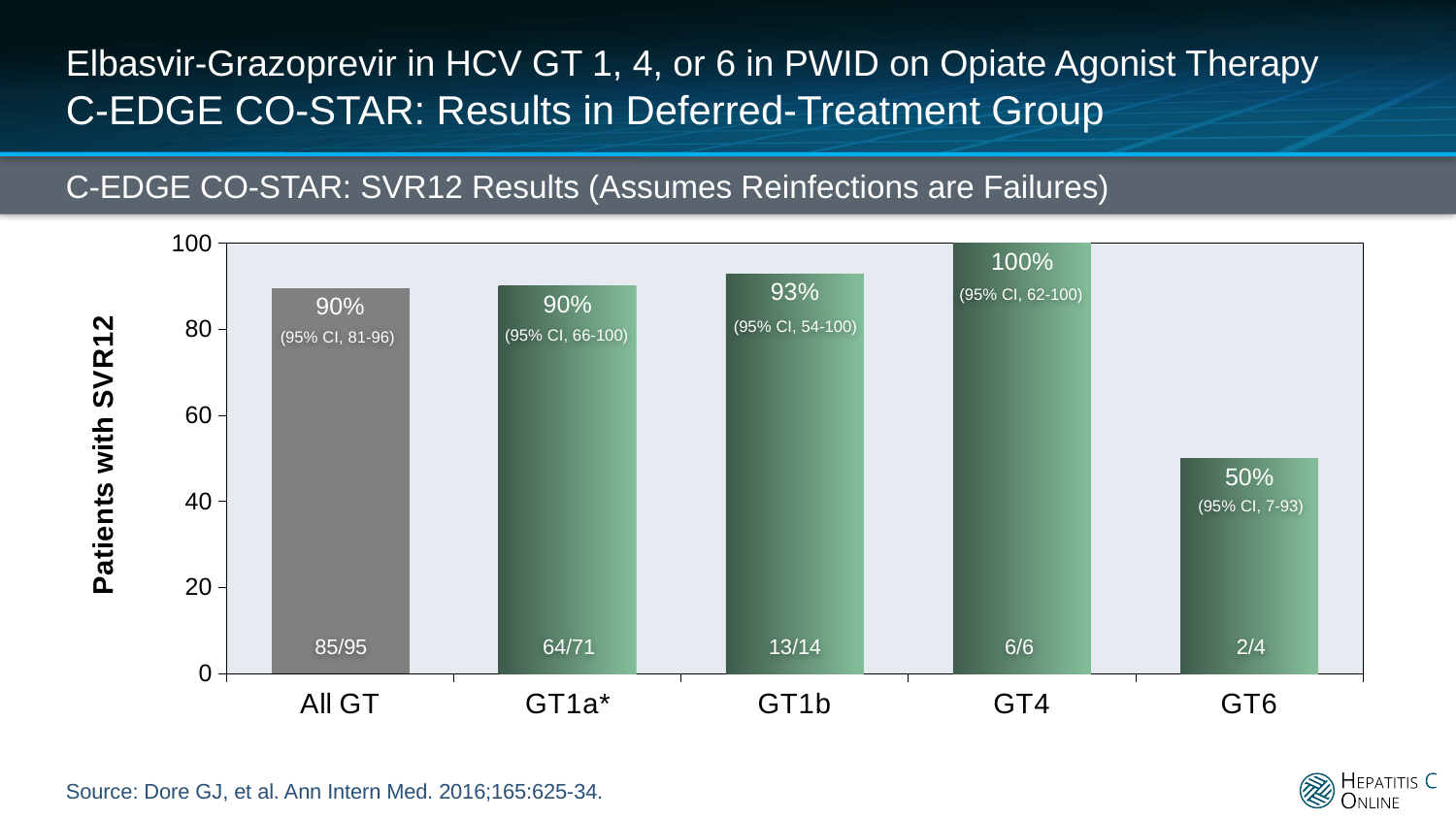
What is the SVR12 rate for the All GT group? 90% What type of chart is shown? bar chart How many genotype categories are shown on the x axis? 5 What is the title of the chart? C-EDGE CO-STAR: SVR12 Results (Assumes Reinfections are Failures) What fraction of patients achieved SVR12 in the GT1b group? 13/14 Which genotype group has the lowest SVR12 rate? GT6 What is the label of the y axis? Patients with SVR12 Is the SVR12 rate for GT1b higher or lower than for GT6? higher Which genotype group has the highest SVR12 rate? GT4 What is the 95% CI shown for GT6? 7-93 What is the SVR12 rate for GT4? 100% What is the difference in SVR12 rate between GT4 and GT6? 50%